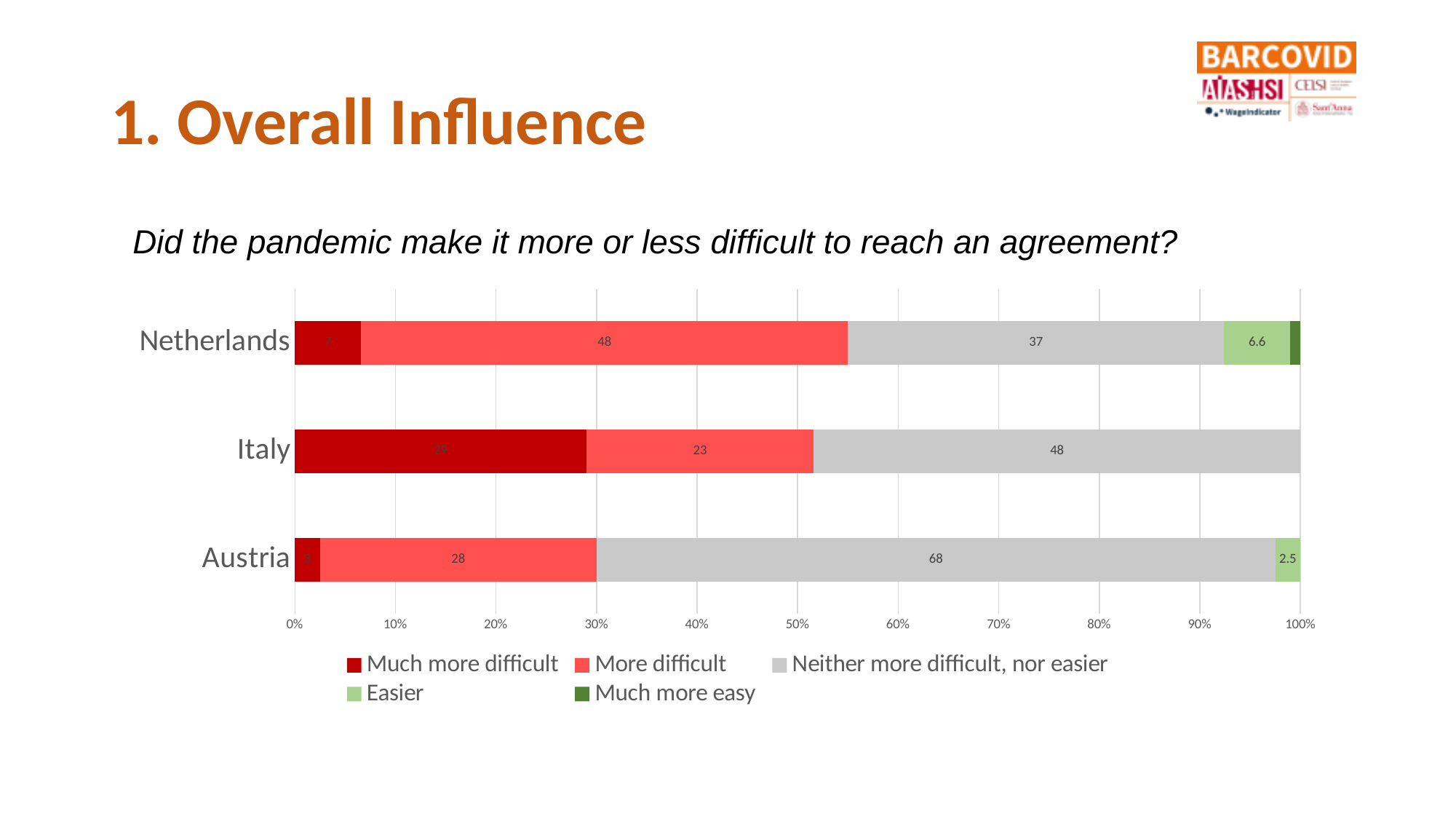
What kind of chart is shown on the slide? Stacked bar chart How many series does the legend list? 5 Which country has the highest value for 'Neither more difficult, nor easier'? Austria Which is larger: the 'More difficult' value for the Netherlands or for Italy? Netherlands What is the value for 'Easier' for the Netherlands? 6.6 How many countries are shown on the chart? 3 What is the value for 'More difficult' for the Netherlands? 48 What is the value for 'Easier' for Austria? 2.5 What is the value for 'Neither more difficult, nor easier' for Italy? 48 What is the value for 'Neither more difficult, nor easier' for Austria? 68 Is the 'Much more difficult' value for Italy greater or less than 20%? greater What is the difference between the 'Neither more difficult, nor easier' values for Austria and Italy? 20